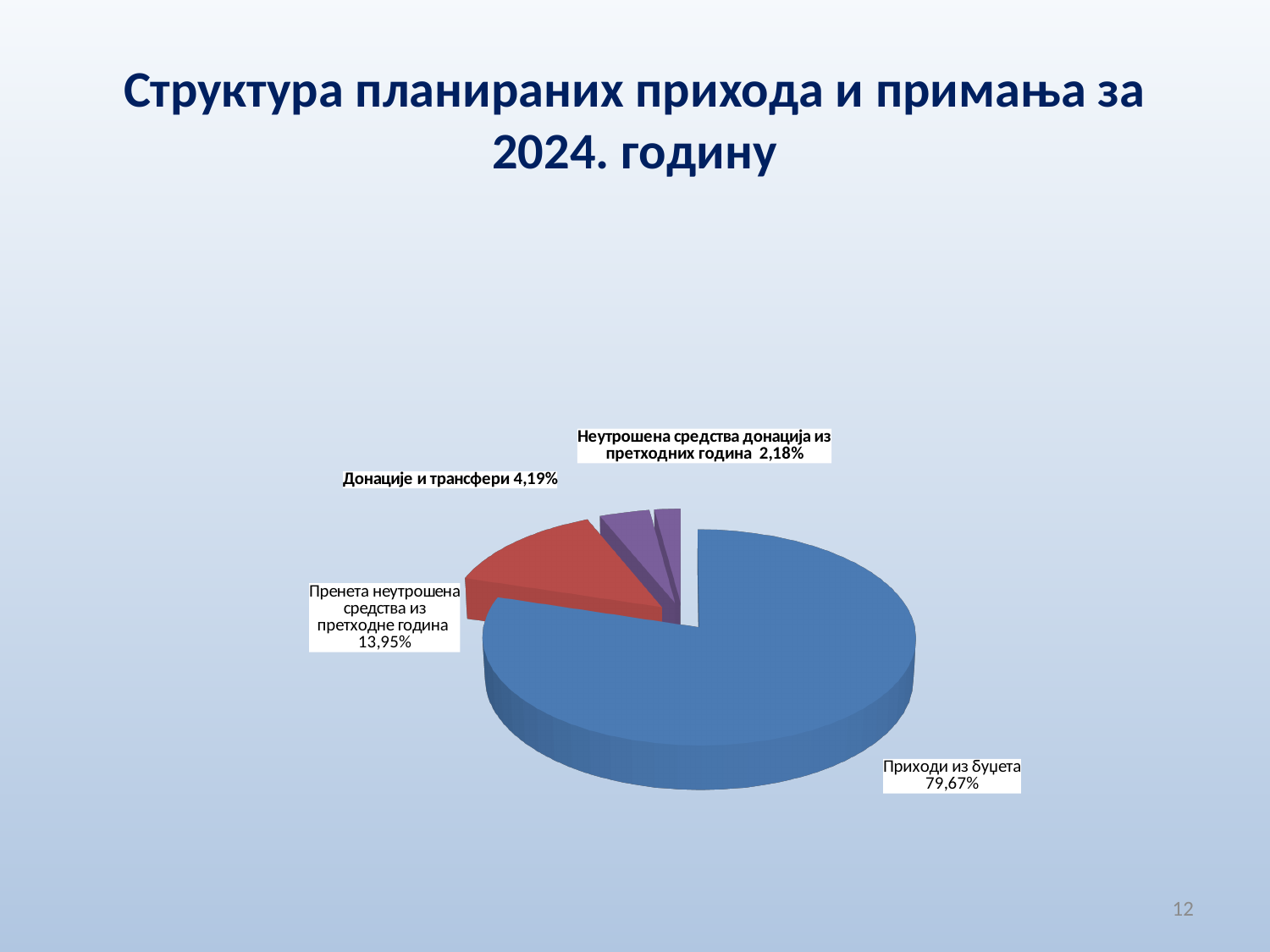
What share of the pie does Приходи из буџета represent? 79,67% Which category has the smallest share of the pie? Неутрошена средства донација из претходних година Which category has the largest share of the pie? Приходи из буџета What is the difference in percentage points between Приходи из буџета and Пренета неутрошена средства из претходне година? 65,72 What percentage is shown for Неутрошена средства донација из претходних година? 2,18% What kind of chart is shown on the slide? Pie chart What is the title of the slide containing the chart? Структура планираних прихода и примања за 2024. годину Which is larger: Донације и трансфери or Пренета неутрошена средства из претходне година? Пренета неутрошена средства из претходне година What percentage is shown for Пренета неутрошена средства из претходне година? 13,95% What percentage is shown for Донације и трансфери? 4,19% What is the difference in percentage points between Донације и трансфери and Неутрошена средства донација из претходних година? 2,01 How many slices does the pie chart have? 4